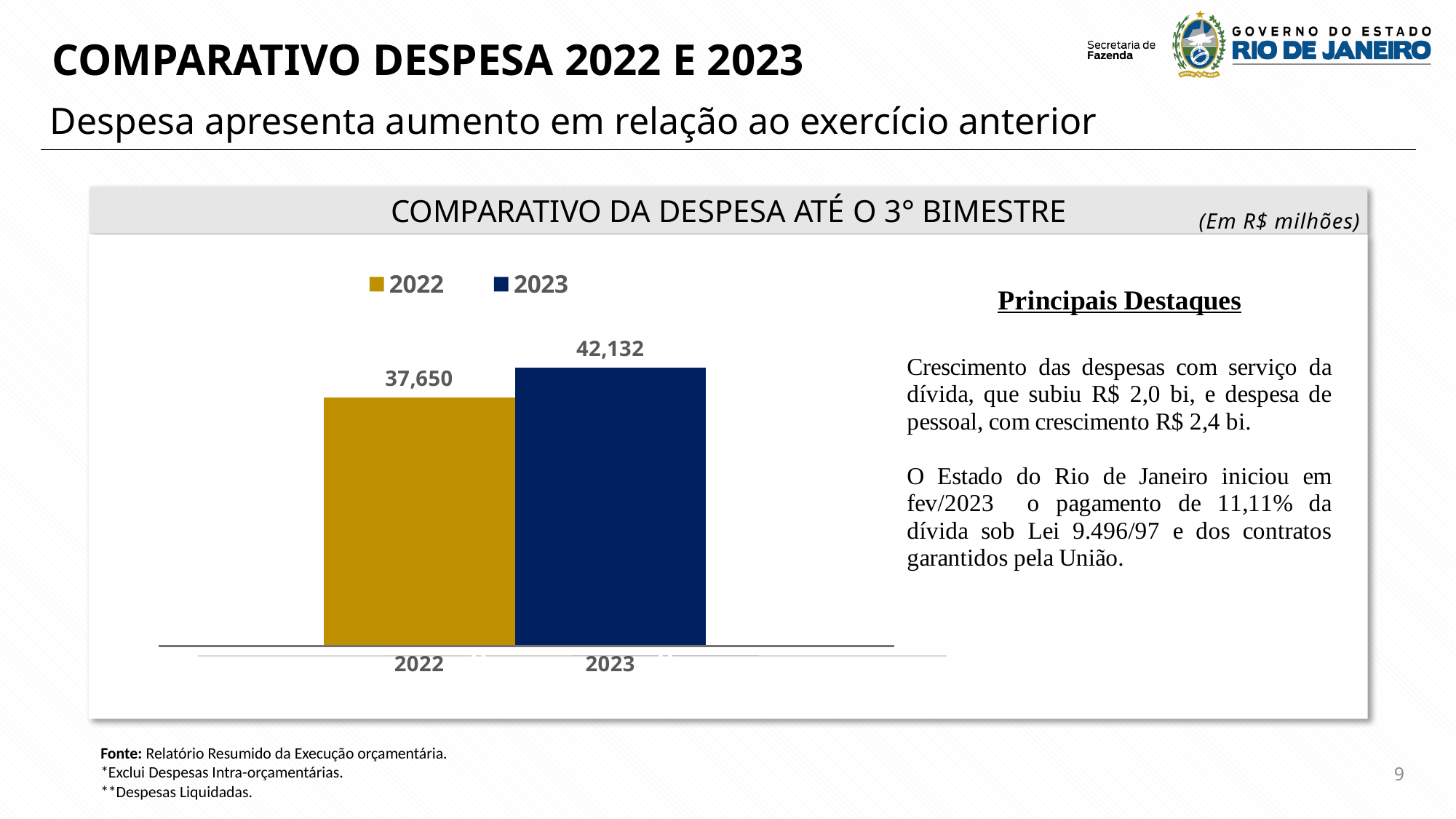
Do the values rise or fall from 2022 to 2023? rise Which year has the lower expense value in the chart? 2022 What kind of chart is shown on the slide? bar chart What is the value shown for 2023 in the chart? 42,132 In what unit are the chart values expressed? Em R$ milhões How many series does the chart legend list? 2 What is the value shown for 2022 in the chart? 37,650 What is the difference between the 2023 and 2022 values in the chart? 4,482 Which year has the higher expense value in the chart? 2023 Is the value for 2022 larger or smaller than the value for 2023? smaller What is the title of the chart? COMPARATIVO DA DESPESA ATÉ O 3° BIMESTRE How many bars are plotted in the chart? 2